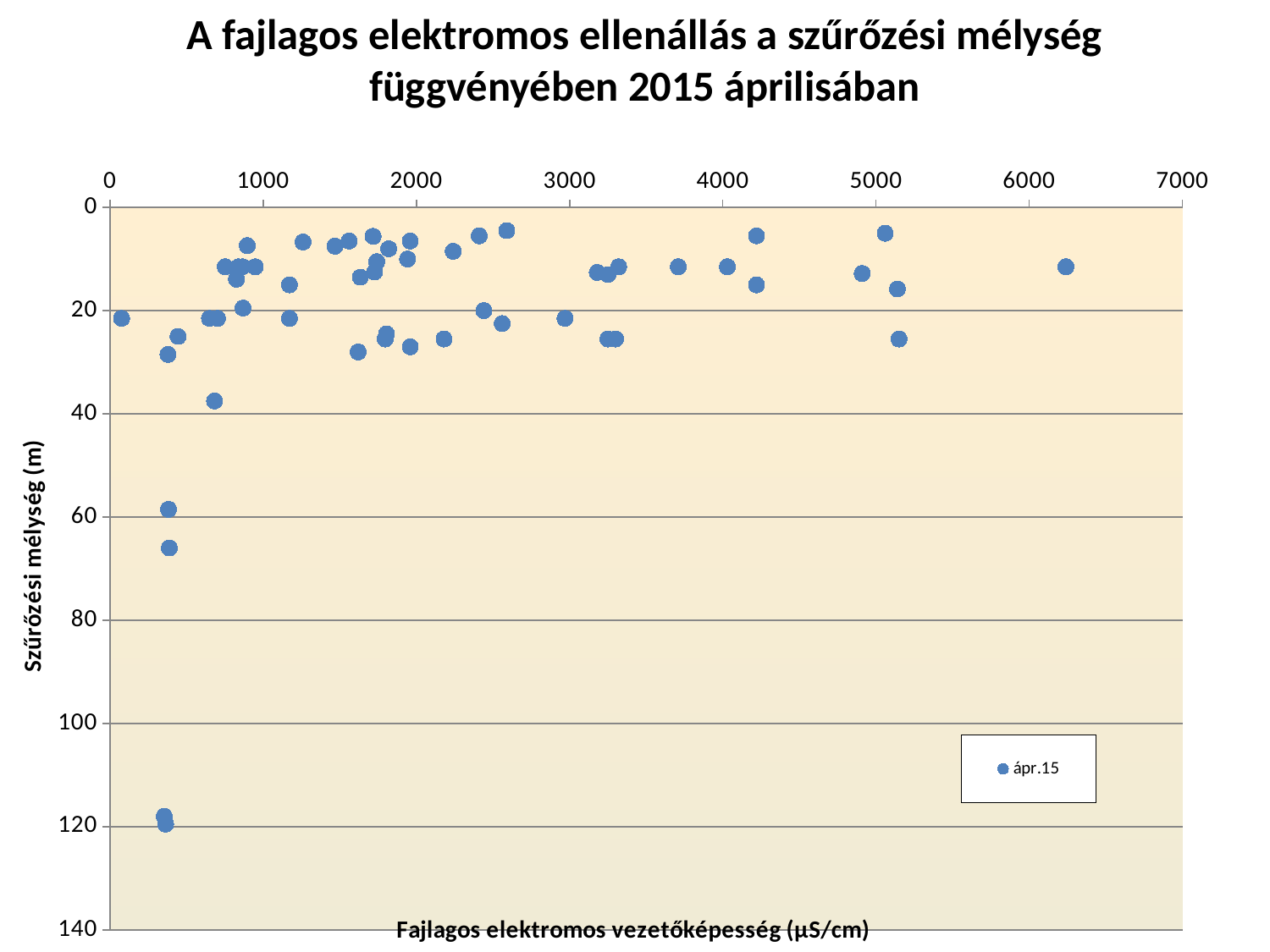
What is the label of the vertical axis? Szűrőzési mélység (m) How many series does the legend list? 1 Is the depth of the deepest plotted point greater or less than 100? greater Is the conductivity of the deepest plotted point greater or less than 1000? less Is the depth of the rightmost plotted point greater or less than 20? less What is the legend entry for the plotted series? ápr.15 What kind of chart is shown on the slide? scatter chart